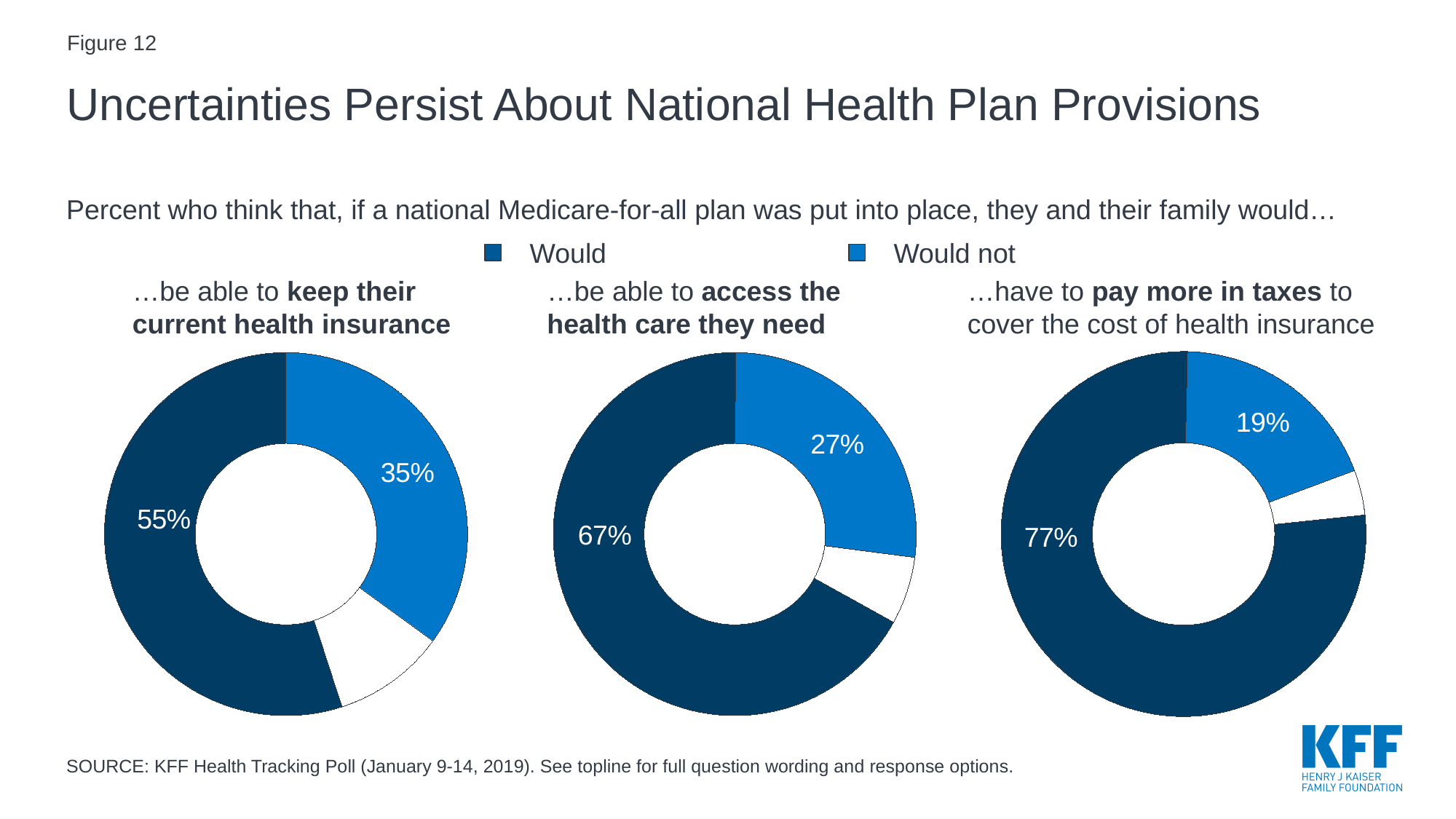
In the chart '...be able to keep their current health insurance', what percent say they would? 55% In the chart '...have to pay more in taxes to cover the cost of health insurance', what is the difference between the 'Would' and 'Would not' percentages? 58 percentage points In the chart '...be able to keep their current health insurance', what percent say they would not? 35% In the chart '...have to pay more in taxes to cover the cost of health insurance', what percent say they would not? 19% In the chart '...be able to access the health care they need', what percent say they would? 67% In the chart '...be able to keep their current health insurance', what is the difference between the 'Would' and 'Would not' percentages? 20 percentage points In the chart '...have to pay more in taxes to cover the cost of health insurance', what percent say they would? 77% How many entries does the legend list? 2 Across the three charts, which one has the highest 'Would' percentage? ...have to pay more in taxes to cover the cost of health insurance In the chart '...be able to access the health care they need', what percent say they would not? 27% Across the three charts, which one has the lowest 'Would not' percentage? ...have to pay more in taxes to cover the cost of health insurance What kind of chart is used on this slide? Donut (pie) chart